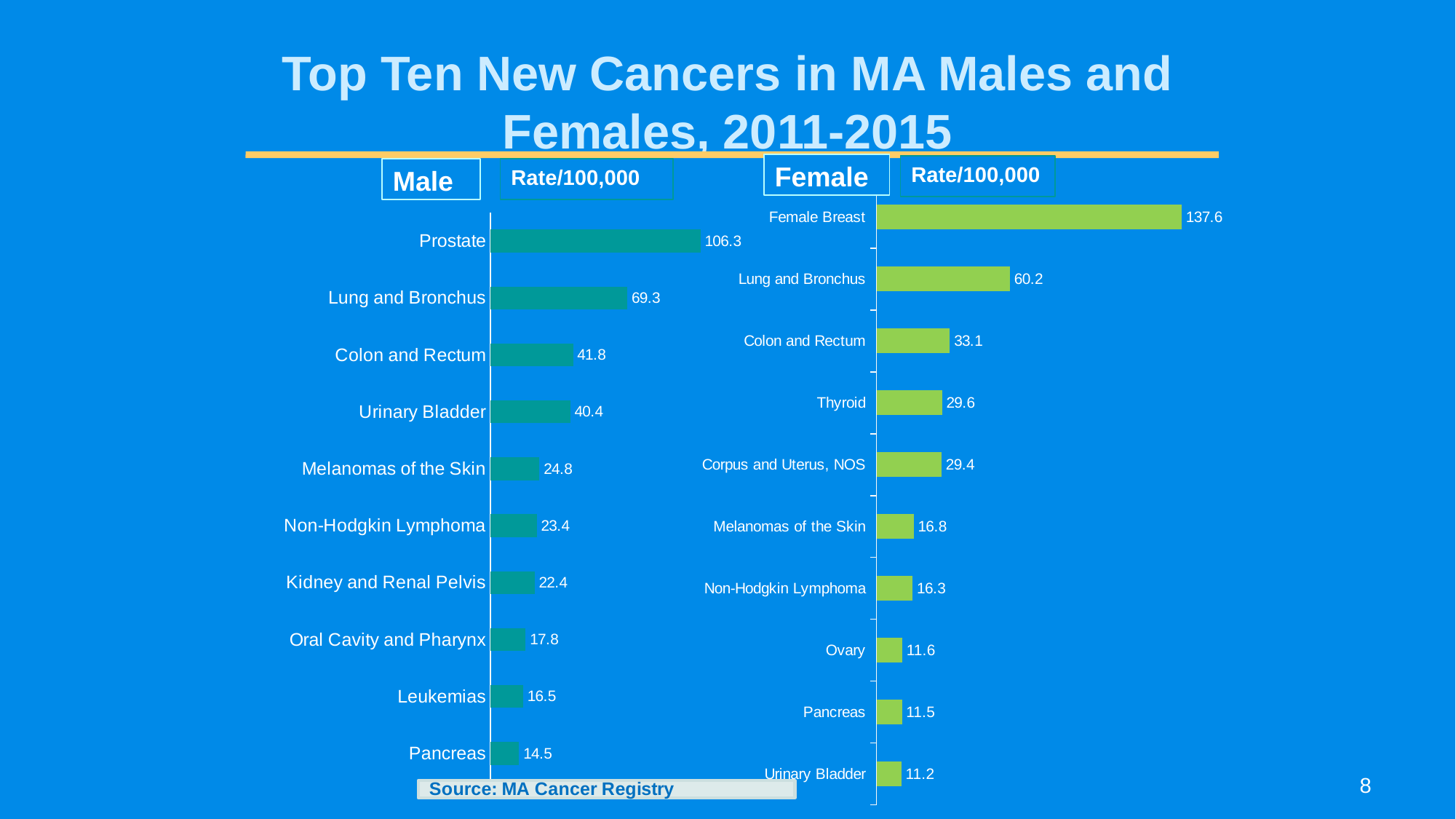
In the Male chart, what is the difference between the rates for Prostate and Lung and Bronchus? 37.0 In the Male chart, how many cancer categories are shown? 10 What source is cited for the data on the slide? MA Cancer Registry In the Female chart, what is the rate per 100,000 for Thyroid? 29.6 In the Female chart, what is the rate per 100,000 for Urinary Bladder? 11.2 In the Female chart, what is the difference between the rates for Female Breast and Lung and Bronchus? 77.4 What type of chart is used on this slide? Bar chart In the Female chart, how many cancer categories are shown? 10 In the Female chart, which cancer has the highest rate? Female Breast Which is larger: the Male rate for Lung and Bronchus or the Female rate for Lung and Bronchus? Male In the Male chart, which cancer has the lowest rate? Pancreas In the Male chart, what is the rate per 100,000 for Prostate? 106.3